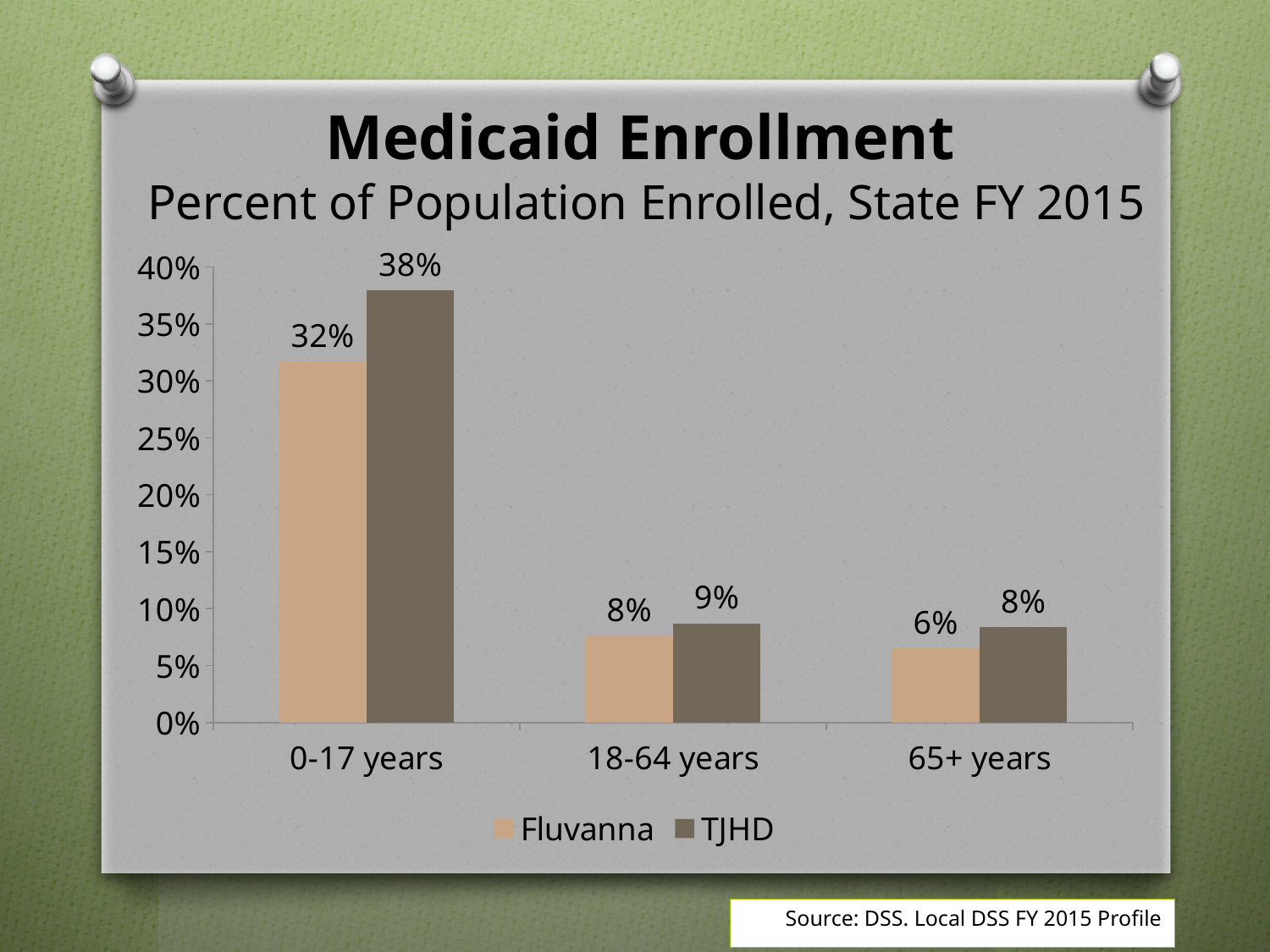
How many series does the legend list? 2 How many age groups are shown on the x axis? 3 What is the TJHD value for 18-64 years? 9% What kind of chart is shown on the slide? bar chart Which age group has the lowest Fluvanna value? 65+ years What is the Fluvanna value for 0-17 years? 32% What is the TJHD value for 0-17 years? 38% What is the difference between the TJHD and Fluvanna values for 0-17 years? 6% Is the Fluvanna value for 0-17 years greater or less than 30%? greater What is the Fluvanna value for 65+ years? 6% Which age group has the highest TJHD value? 0-17 years Which is larger for 65+ years, Fluvanna or TJHD? TJHD